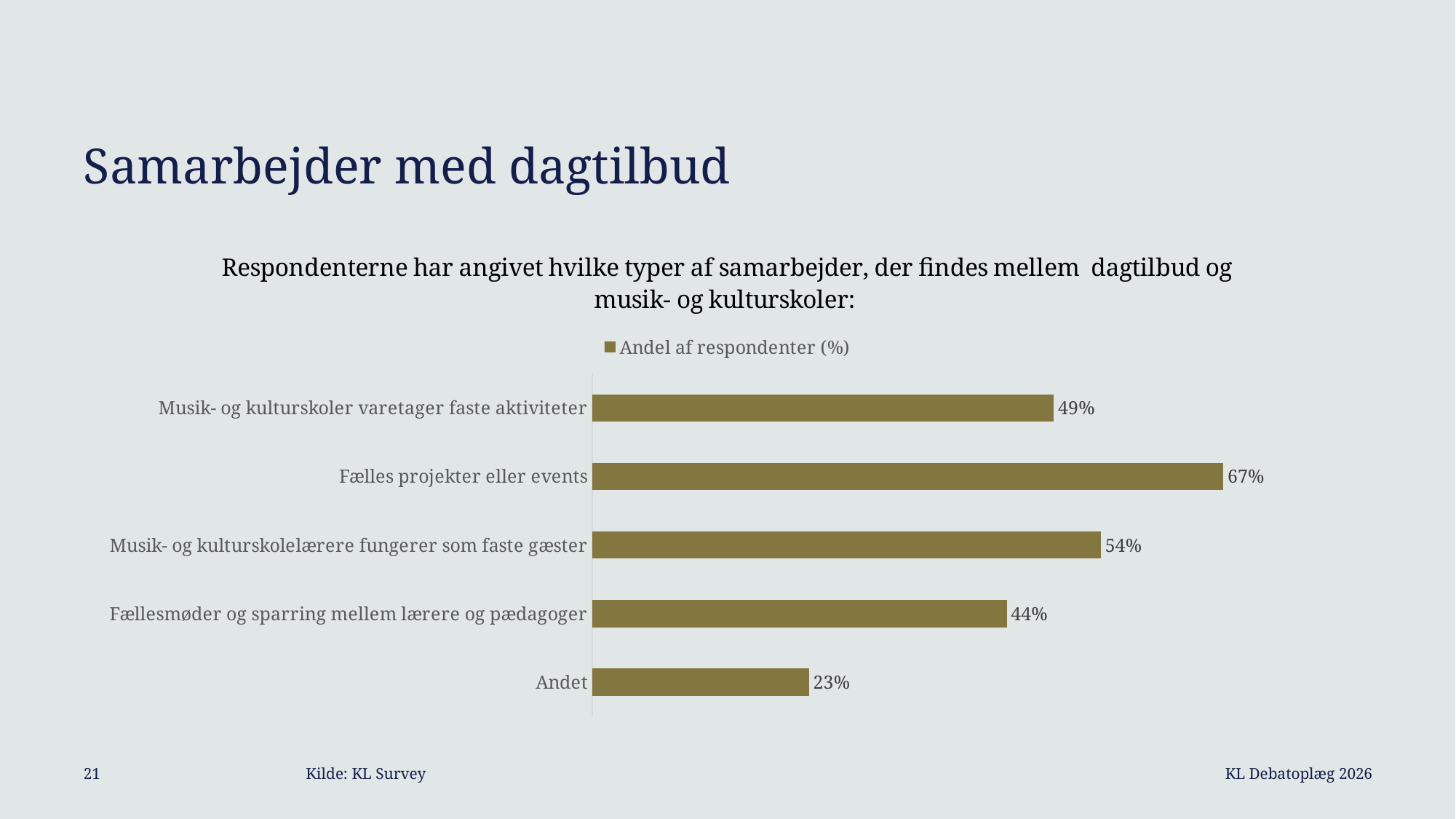
What is the value for "Musik- og kulturskoler varetager faste aktiviteter"? 49% What is the value for "Fælles projekter eller events"? 67% How many categories are shown in the chart? 5 Which category has the highest value? Fælles projekter eller events What is the legend entry of the chart? Andel af respondenter (%) Which is larger: "Musik- og kulturskolelærere fungerer som faste gæster" or "Fællesmøder og sparring mellem lærere og pædagoger"? Musik- og kulturskolelærere fungerer som faste gæster What is the value for "Andet"? 23% What kind of chart is shown on the slide? Bar chart Which category has the lowest value? Andet What is the value for "Fællesmøder og sparring mellem lærere og pædagoger"? 44% What is the difference between "Fælles projekter eller events" and "Andet"? 44 percentage points What is the difference between "Musik- og kulturskolelærere fungerer som faste gæster" and "Musik- og kulturskoler varetager faste aktiviteter"? 5 percentage points